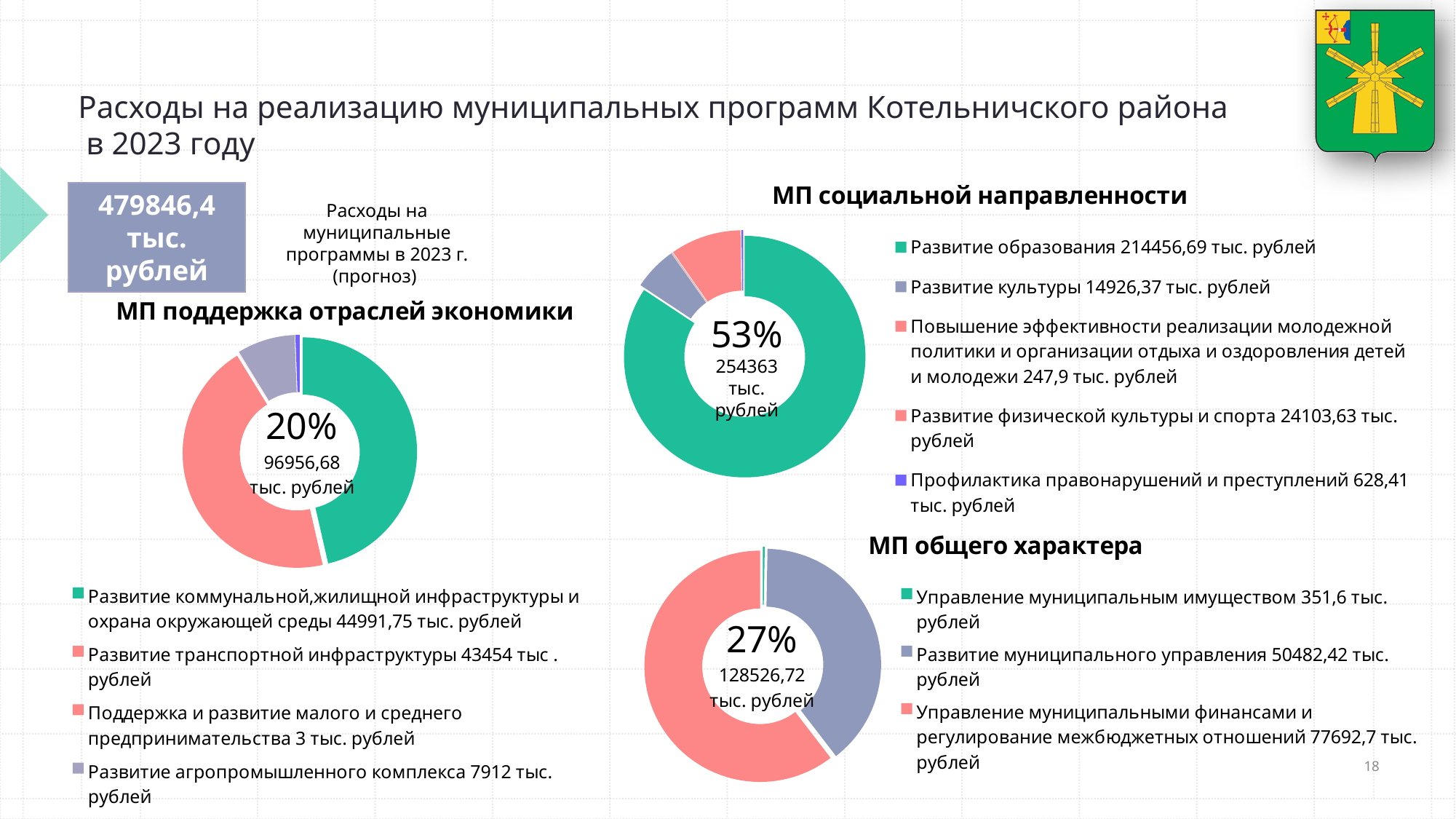
In the 'МП социальной направленности' chart, which category has the largest value? Развитие образования In the 'МП поддержка отраслей экономики' chart, which is larger: 'Развитие коммунальной, жилищной инфраструктуры и охрана окружающей среды' or 'Развитие транспортной инфраструктуры'? Развитие коммунальной, жилищной инфраструктуры и охрана окружающей среды How many categories does the legend of the 'МП социальной направленности' chart list? 5 In the 'МП поддержка отраслей экономики' chart, what is the value for 'Развитие агропромышленного комплекса'? 7912 тыс. рублей In the 'МП общего характера' chart, what is the difference between 'Управление муниципальными финансами и регулирование межбюджетных отношений' and 'Развитие муниципального управления'? 27210,28 тыс. рублей In the 'МП поддержка отраслей экономики' chart, which category has the smallest value? Поддержка и развитие малого и среднего предпринимательства In the 'МП общего характера' chart, which category has the smallest value? Управление муниципальным имуществом In the 'МП общего характера' chart, what is the value for 'Развитие муниципального управления'? 50482,42 тыс. рублей What type of chart is used for 'МП поддержка отраслей экономики'? Pie (donut) chart How many categories does the legend of the 'МП общего характера' chart list? 3 In the 'МП социальной направленности' chart, what is the value for 'Развитие образования'? 214456,69 тыс. рублей What share of total expenditures is shown in the centre of the 'МП социальной направленности' chart? 53%